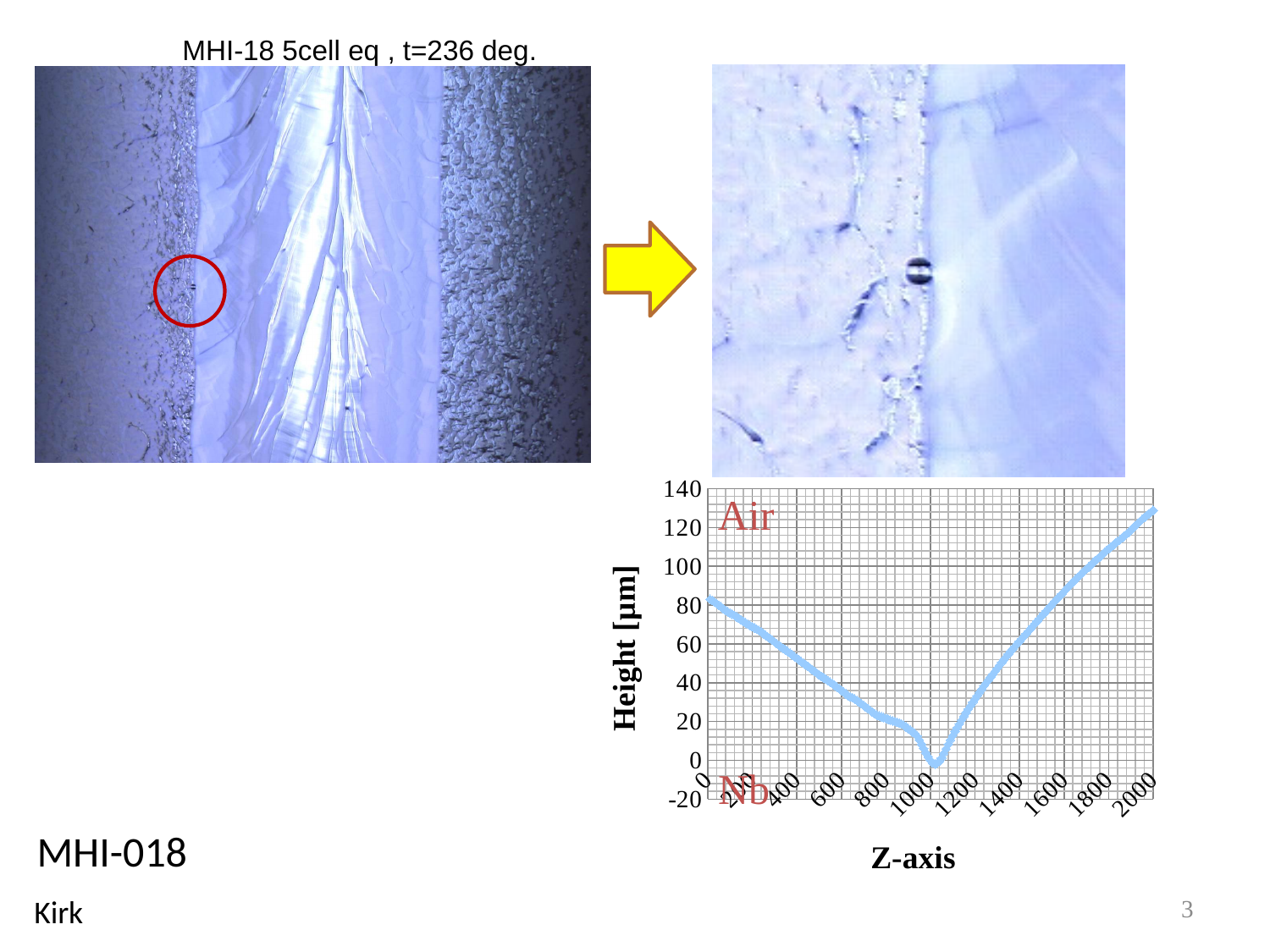
What is the label of the vertical axis of the chart? Height [µm] What kind of chart is shown at the bottom right of the slide? line chart Is the height at Z-axis = 0 greater or less than 60? greater Which is larger, the height at Z-axis = 0 or at Z-axis = 2000? Z-axis = 2000 Is the height at Z-axis = 1600 greater or less than 60? greater What is the label of the horizontal axis of the chart? Z-axis Is the height at Z-axis = 2000 greater or less than 100? greater Does the height rise or fall as the Z-axis goes from 1200 to 2000? rise Does the height rise or fall as the Z-axis goes from 0 to 1000? fall